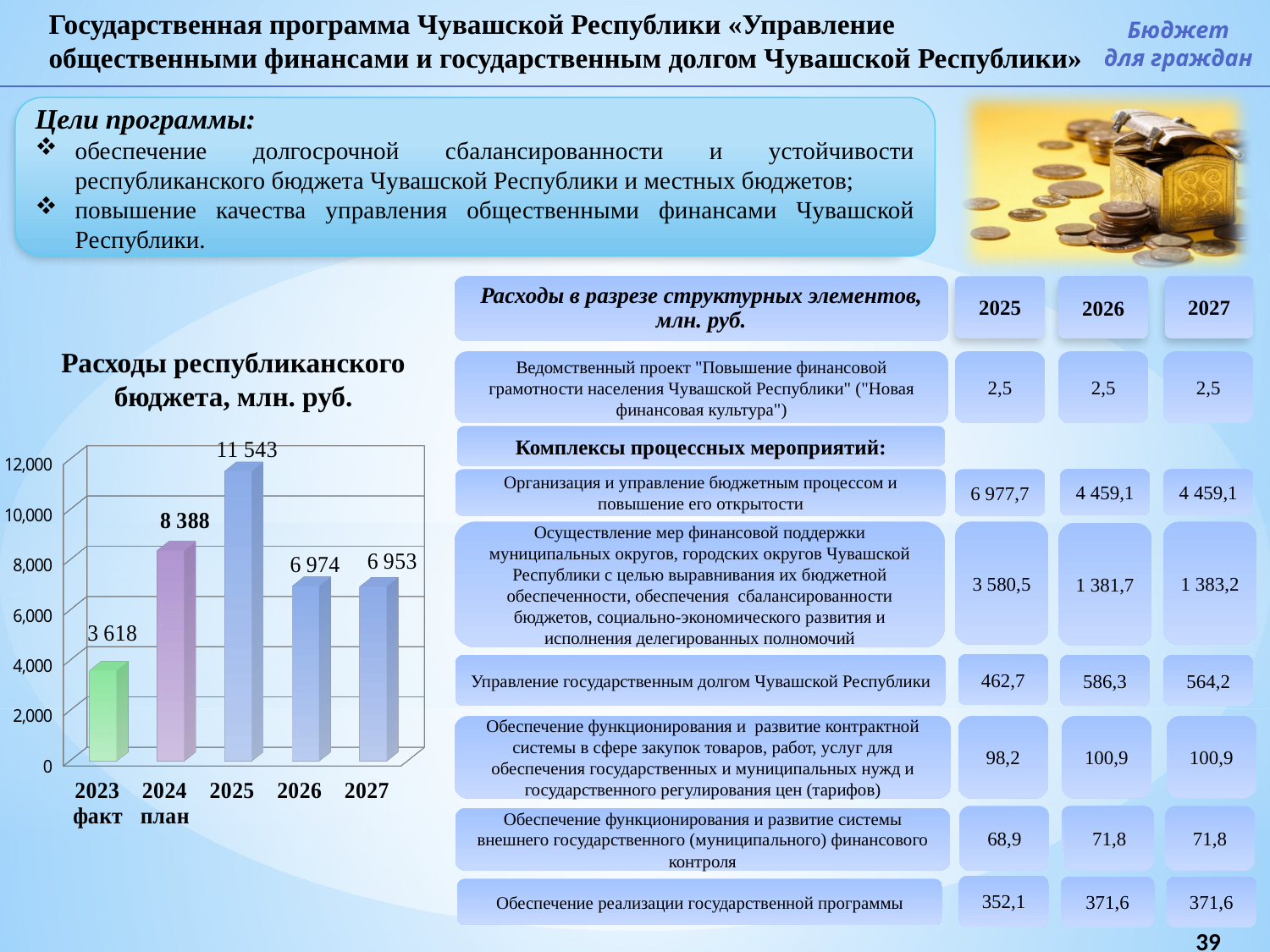
In the chart "Расходы республиканского бюджета, млн. руб.", is the value for 2025 greater or less than 10,000? greater What is the value for 2024 (план) in the chart "Расходы республиканского бюджета, млн. руб."? 8 388 How many years (bars) are shown in the chart "Расходы республиканского бюджета, млн. руб."? 5 What is the value for 2027 in the chart "Расходы республиканского бюджета, млн. руб."? 6 953 Which year has the lowest value in the chart "Расходы республиканского бюджета, млн. руб."? 2023 What kind of chart is "Расходы республиканского бюджета, млн. руб."? bar chart Which year has the highest value in the chart "Расходы республиканского бюджета, млн. руб."? 2025 What is the value for 2023 (факт) in the chart "Расходы республиканского бюджета, млн. руб."? 3 618 In the chart "Расходы республиканского бюджета, млн. руб.", what is the difference between the values for 2025 and 2024? 3 155 In the chart "Расходы республиканского бюджета, млн. руб.", which is larger: the value for 2024 or the value for 2026? 2024 In the chart "Расходы республиканского бюджета, млн. руб.", what is the difference between the values for 2026 and 2027? 21 What is the value for 2025 in the chart "Расходы республиканского бюджета, млн. руб."? 11 543